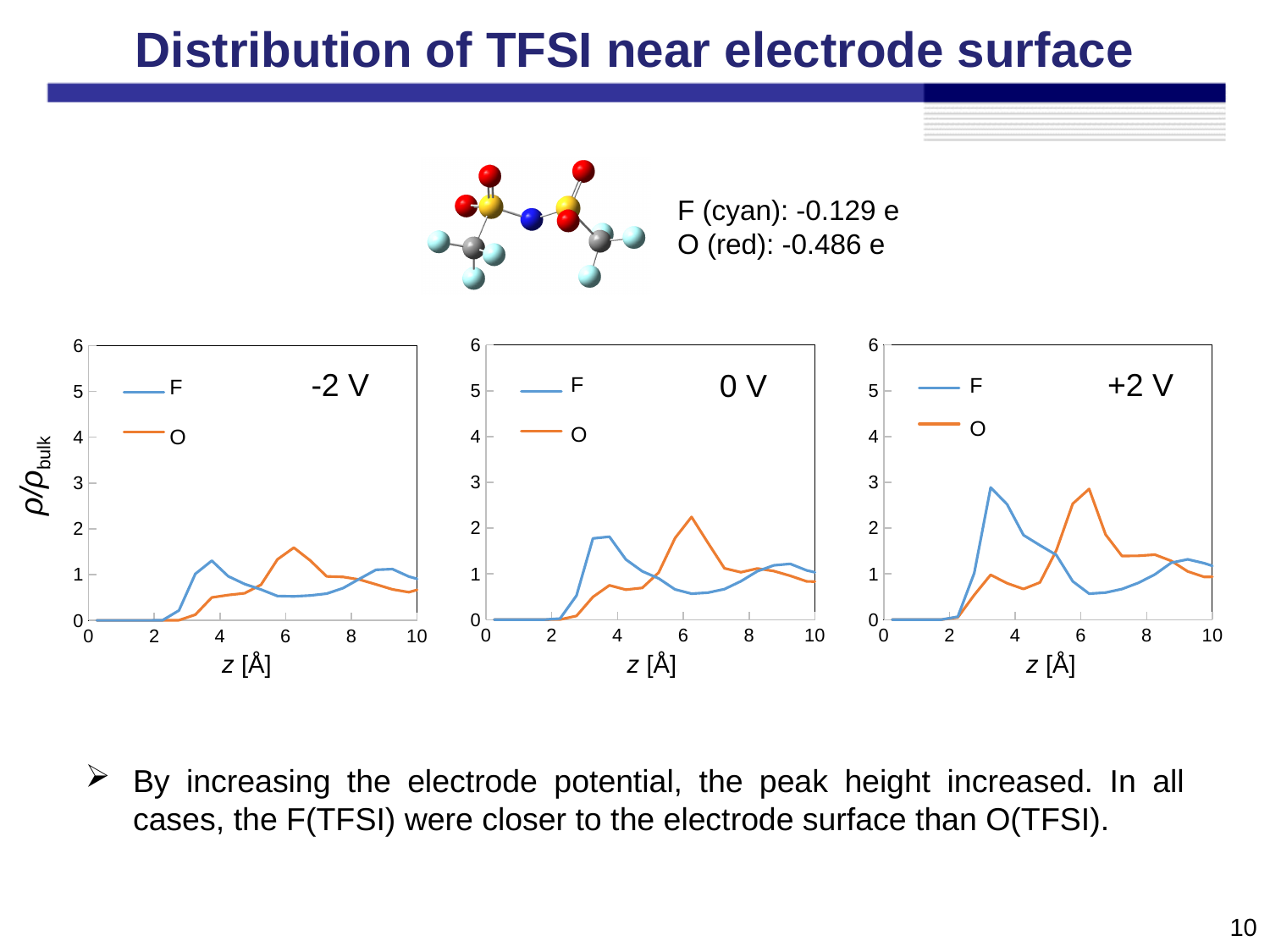
In the -2 V chart, which series reaches a higher peak, F or O? O In the -2 V chart, is the peak value of the O series greater or less than 2? less In the 0 V chart, which series reaches a higher peak, F or O? O In the 0 V chart, is the peak value of the O series greater or less than 2? greater How many charts are shown on the slide? 3 In the +2 V chart, is the peak value of the F series greater or less than 2? greater How many series does the legend of the 0 V chart list? 2 What are the two series named in the legend of the +2 V chart? F and O What kind of chart is the -2 V chart? line chart Across the three charts, which electrode potential shows the highest F peak? +2 V What is the x-axis label on the 0 V chart? z [Å]